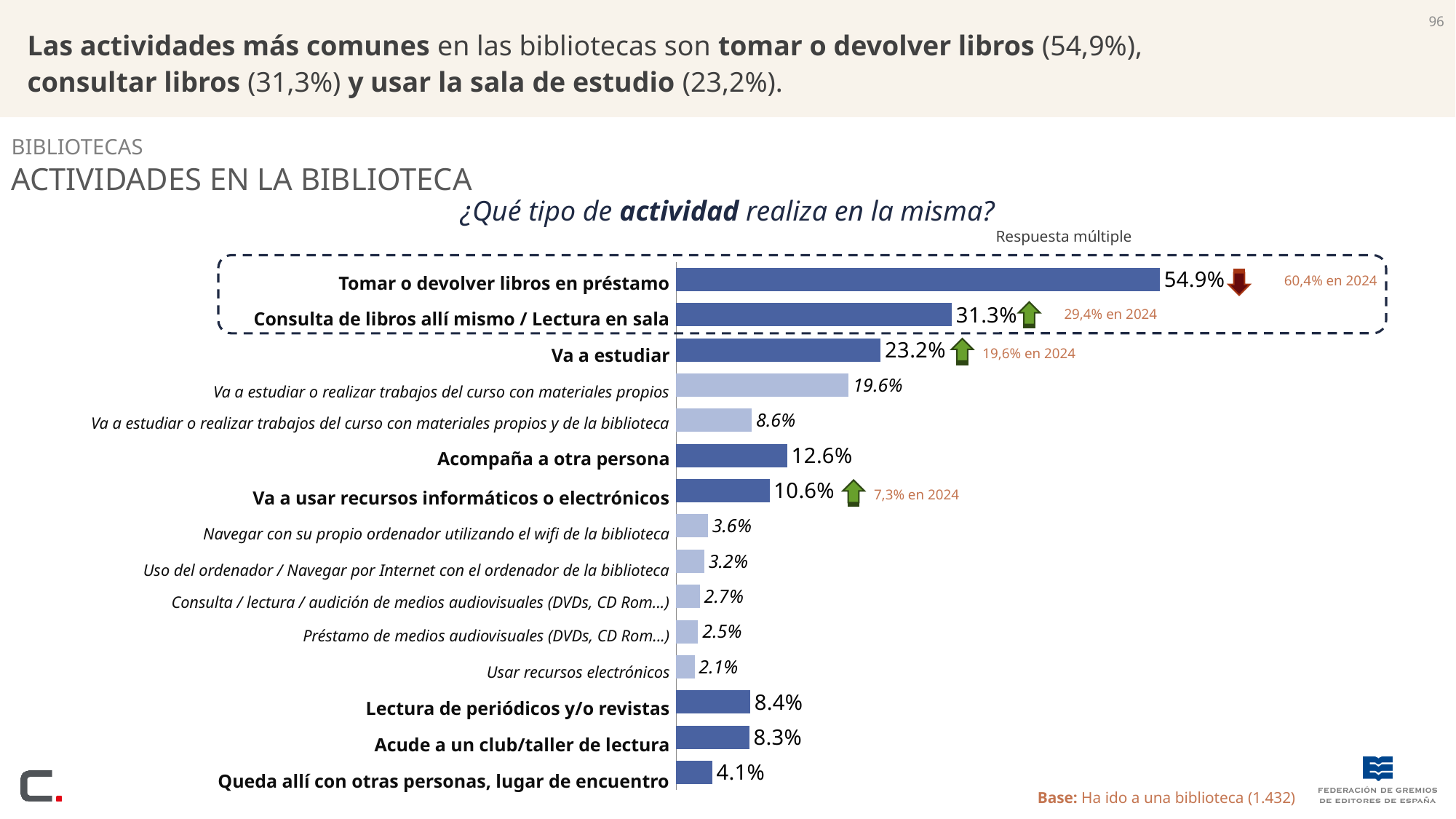
What is the question shown as the chart's title? ¿Qué tipo de actividad realiza en la misma? What is the value for "Va a estudiar"? 23.2% What kind of chart is shown on the slide? Bar chart What is the value for "Acompaña a otra persona"? 12.6% What was the value for "Tomar o devolver libros en préstamo" in 2024, according to the annotation? 60,4% What is the difference between "Tomar o devolver libros en préstamo" and "Consulta de libros allí mismo / Lectura en sala"? 23.6% How many activity categories are shown in the chart? 15 Which is larger, "Lectura de periódicos y/o revistas" or "Queda allí con otras personas, lugar de encuentro"? Lectura de periódicos y/o revistas Which activity has the highest value? Tomar o devolver libros en préstamo What is the value for "Usar recursos electrónicos"? 2.1% What is the value for "Tomar o devolver libros en préstamo"? 54.9% Which activity has the lowest value? Usar recursos electrónicos